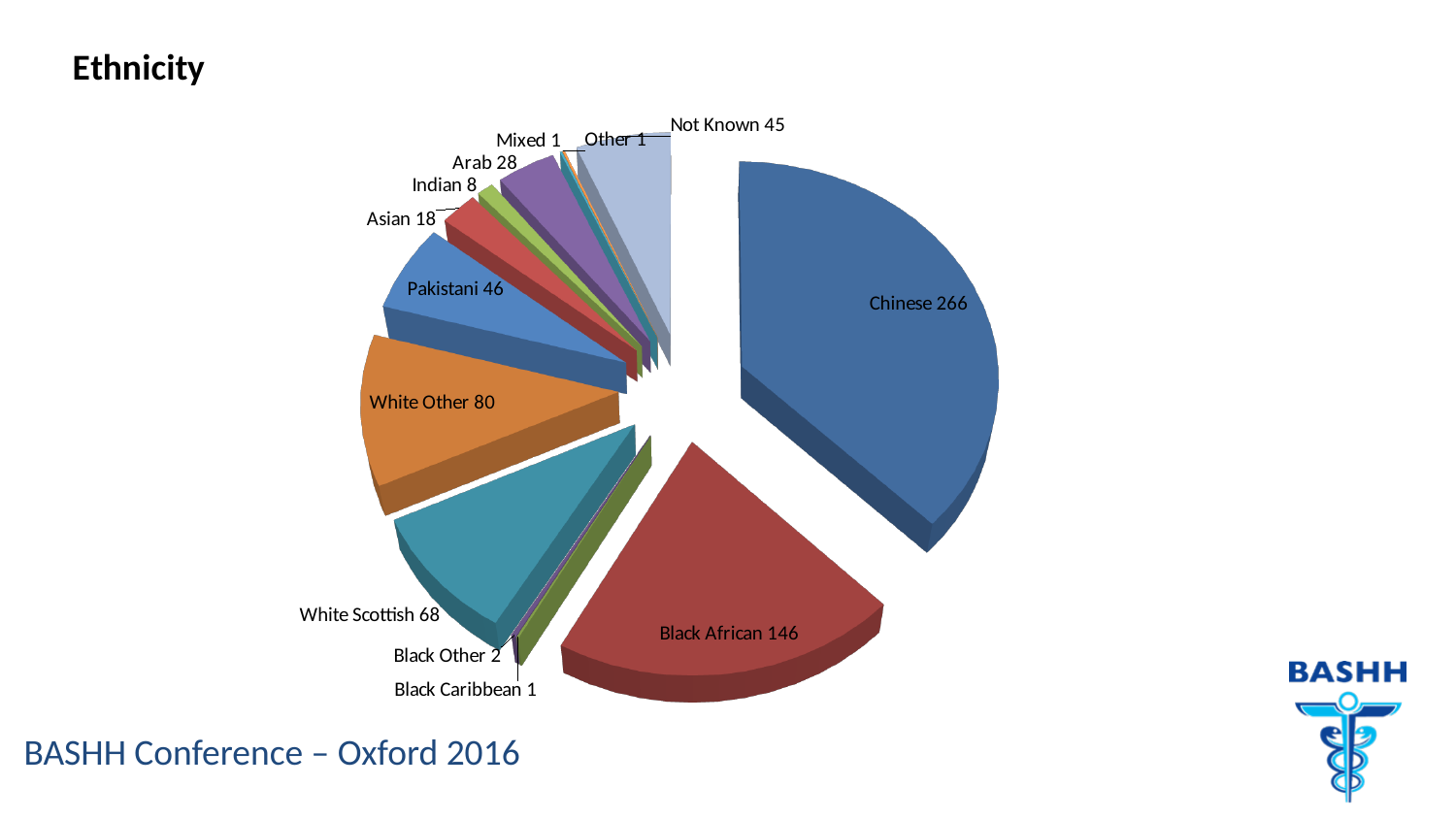
What is the value for Not Known? 45 How many categories are shown in the pie chart? 13 What is the difference between the values for Chinese and Black African? 120 What is the value for White Other? 80 Which is larger, White Scottish or White Other? White Other What is the value for Black African? 146 What is the title of the chart? Ethnicity What type of chart is shown on the slide? Pie chart What is the value for Pakistani? 46 Which category has the largest slice? Chinese What is the value for Chinese? 266 What is the difference between the values for Arab and Indian? 20